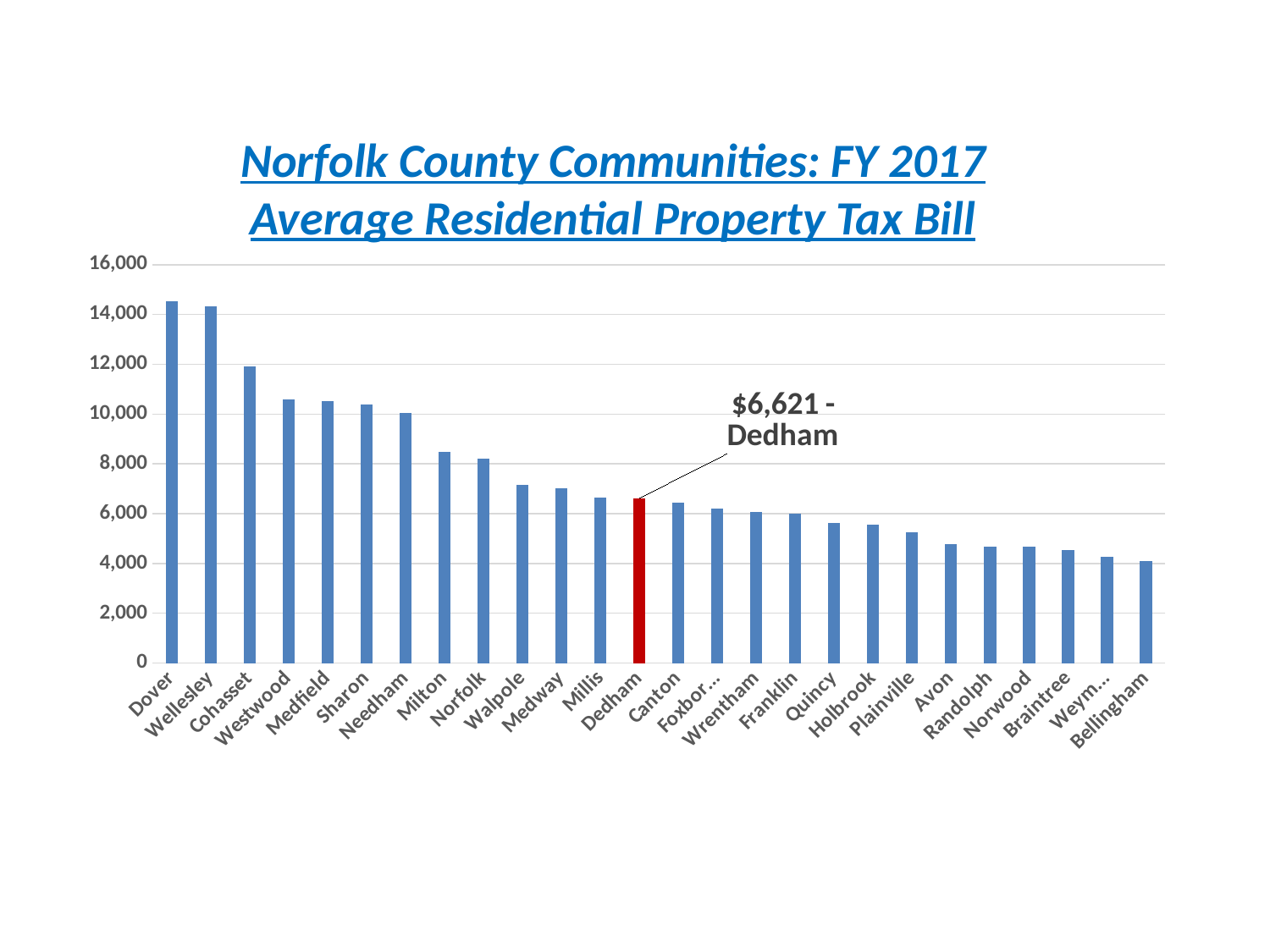
Which has a higher average residential property tax bill, Needham or Canton? Needham Is the value for Milton greater or less than 8,000? greater Is the value for Bellingham greater or less than 6,000? less What is the average residential property tax bill for Dedham? $6,621 What fiscal year does the chart title refer to? FY 2017 What kind of chart is shown on the slide? bar chart Is the value for Dover greater or less than 14,000? greater How many communities are plotted in the chart? 26 Which has a higher average residential property tax bill, Dover or Cohasset? Dover Which community's bar is highlighted in red? Dedham Do the values rise or fall moving from left to right along the x axis? fall